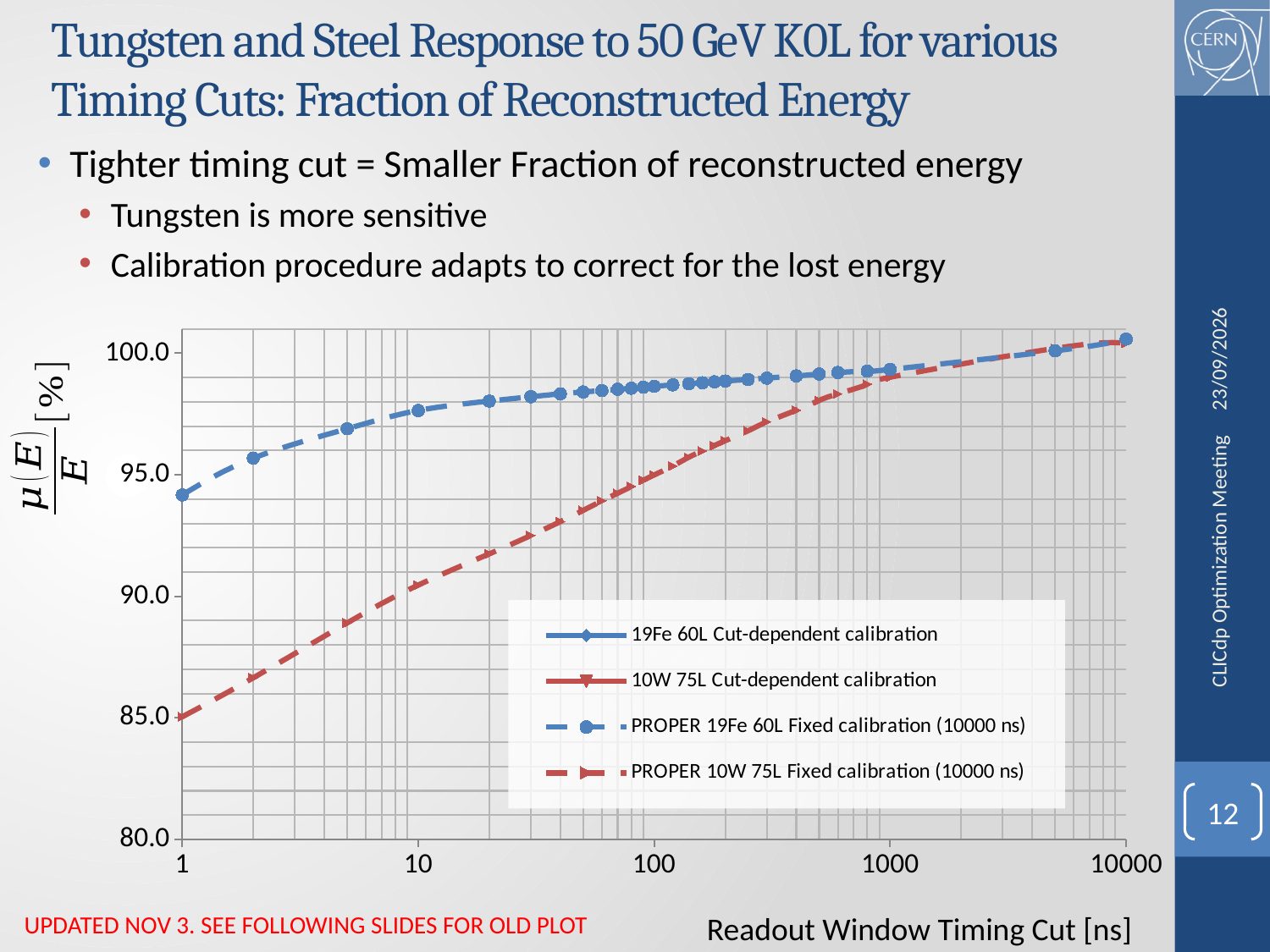
Is the value for PROPER 19Fe 60L Fixed calibration at a timing cut of 100 ns greater or less than 95.0? greater Do the plotted values rise or fall as the readout window timing cut increases along the x axis? rise Is the value for PROPER 19Fe 60L Fixed calibration at a timing cut of 1 ns greater or less than 90.0? greater Is the value for PROPER 19Fe 60L Fixed calibration at a timing cut of 10 ns greater or less than 95.0? greater At a timing cut of 1 ns, which series has the higher value: PROPER 19Fe 60L Fixed calibration or PROPER 10W 75L Fixed calibration? PROPER 19Fe 60L Fixed calibration What kind of chart is shown on the slide? line chart How many series does the legend list? 4 At a timing cut of 10 ns, which series has the lower value: PROPER 19Fe 60L Fixed calibration or PROPER 10W 75L Fixed calibration? PROPER 10W 75L Fixed calibration What is the label of the x axis of the chart? Readout Window Timing Cut [ns] What colour is the line for the PROPER 10W 75L Fixed calibration (10000 ns) series? red